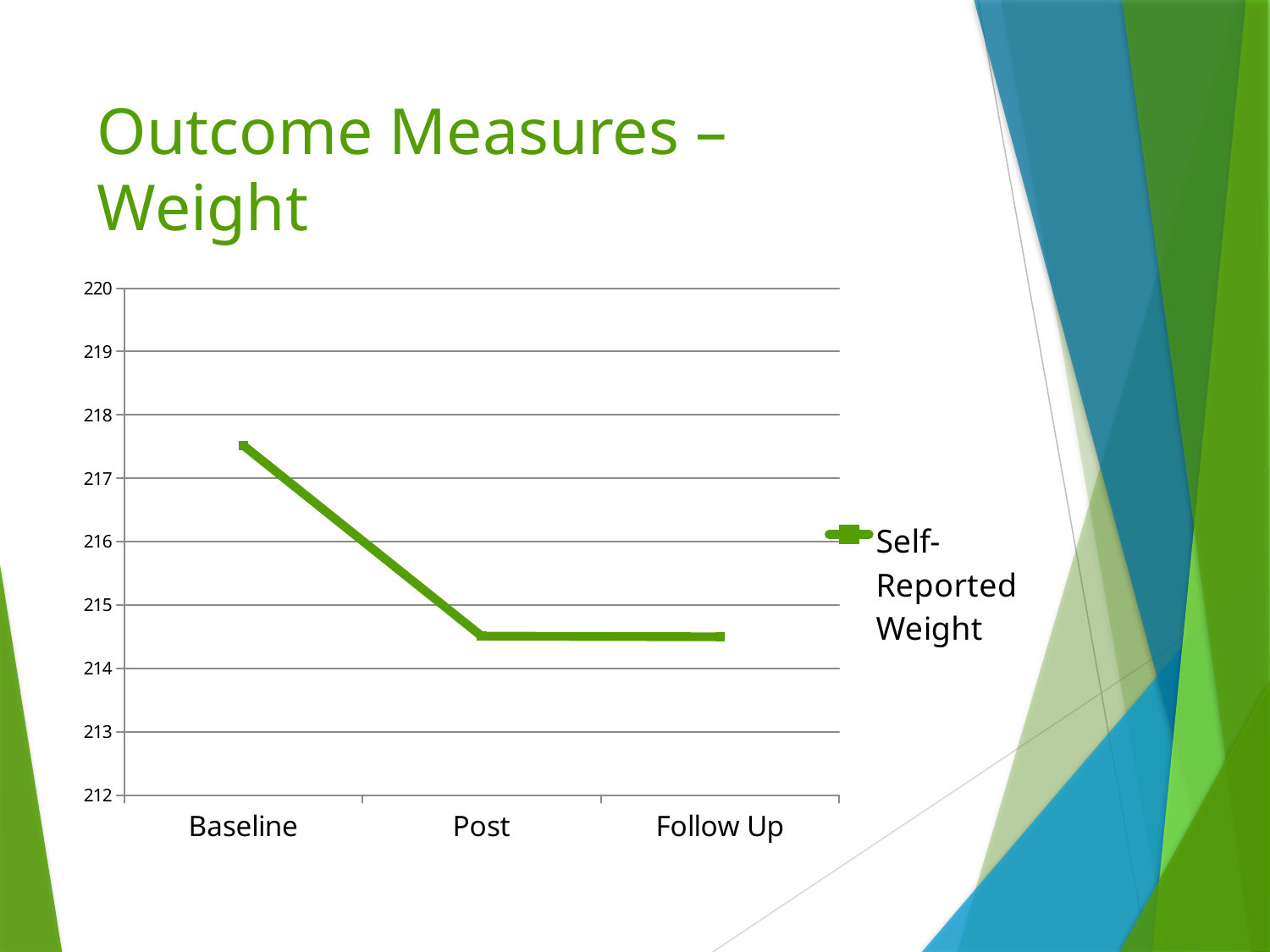
Is the self-reported weight at Post greater or less than 215? less Is the self-reported weight at Follow Up greater or less than 214? greater What is the name of the series shown in the legend? Self-Reported Weight Which is larger, the self-reported weight at Baseline or at Post? Baseline How many series does the legend list? 1 How many points are plotted along the x axis? 3 What are the lowest and highest values shown on the y axis? 212 and 220 Is the self-reported weight at Baseline greater or less than 217? greater Which time point has the highest self-reported weight? Baseline What kind of chart is shown on the slide? line chart Does the self-reported weight rise or fall from Baseline to Post? fall